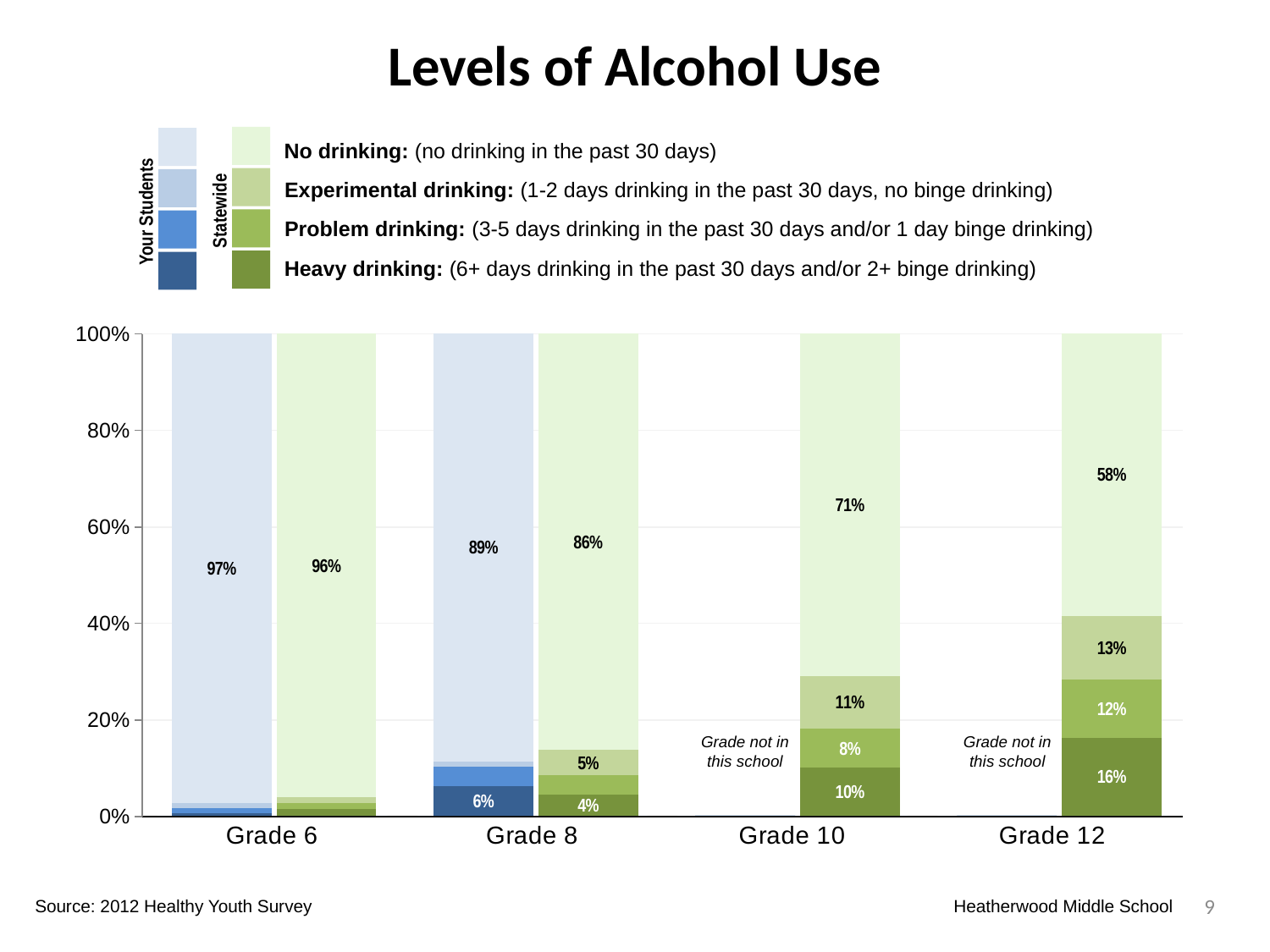
What is the difference between the Statewide no drinking percentages for Grade 10 and Grade 12? 13% What percentage of Your Students in Grade 6 reported no drinking? 97% Which grade has the lowest Statewide no drinking percentage? Grade 12 What kind of chart is shown on the slide? Stacked bar chart How does the Statewide no drinking percentage change from Grade 6 to Grade 12? It falls Which grades are marked as not in this school for Your Students? Grade 10 and Grade 12 What is the Statewide no drinking percentage for Grade 8? 86% What is the Statewide experimental drinking percentage for Grade 10? 11% What is the title of the chart? Levels of Alcohol Use What is the Statewide heavy drinking percentage for Grade 12? 16% Which is larger for Grade 8: the no drinking percentage for Your Students or Statewide? Your Students What is the heavy drinking percentage for Your Students in Grade 8? 6%